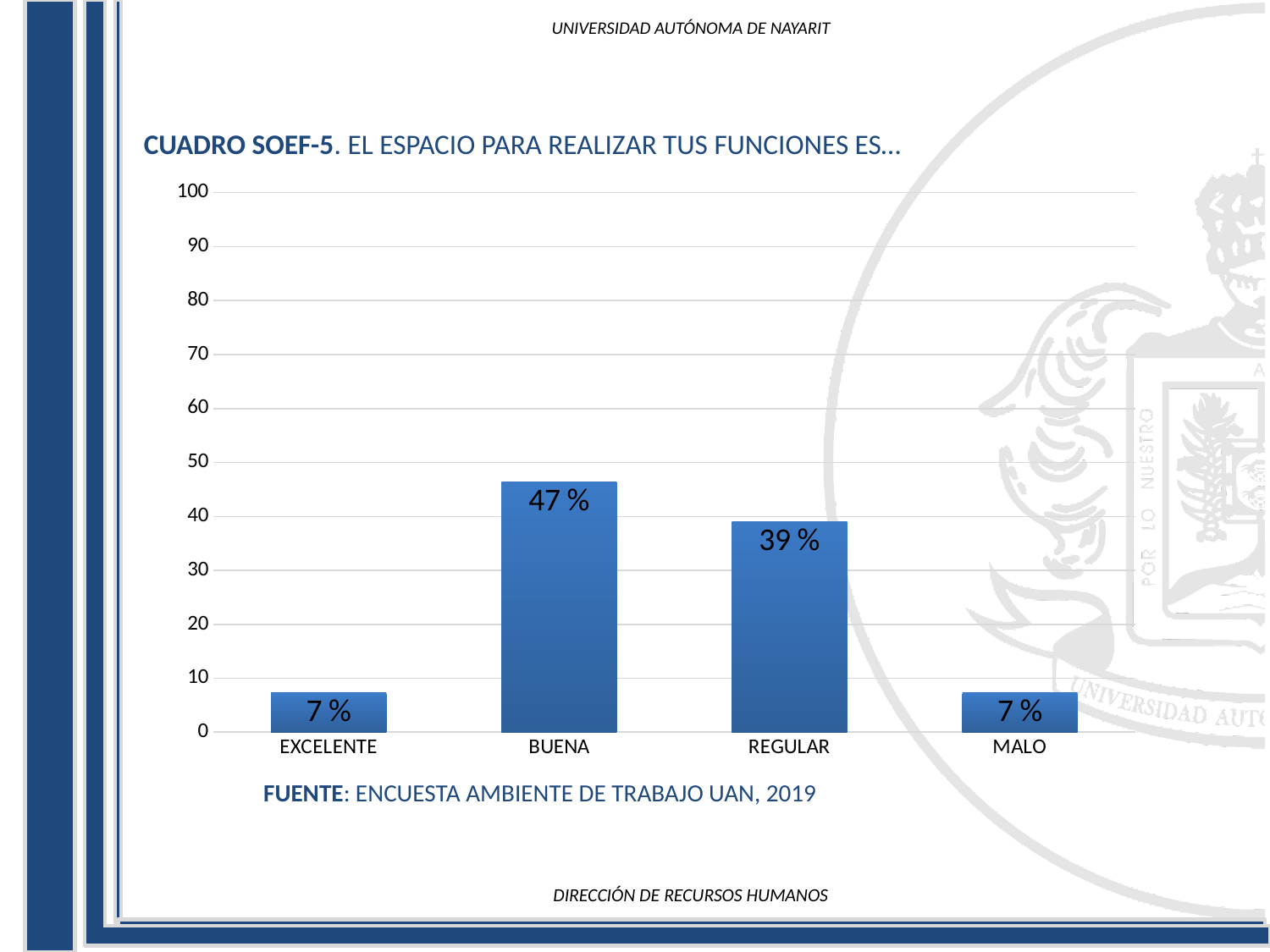
What source is cited below the chart? ENCUESTA AMBIENTE DE TRABAJO UAN, 2019 What is the value for EXCELENTE? 7 % Which category has the highest value? BUENA What is the value for BUENA? 47 % What is the title of the chart? CUADRO SOEF-5. EL ESPACIO PARA REALIZAR TUS FUNCIONES ES… What is the value for MALO? 7 % Which is larger, the value for BUENA or the value for REGULAR? BUENA What kind of chart is shown on the slide? bar chart How many categories are shown on the x axis? 4 What is the value for REGULAR? 39 % What is the difference between the values for BUENA and REGULAR? 8 % Is the value for REGULAR greater or less than 50? less